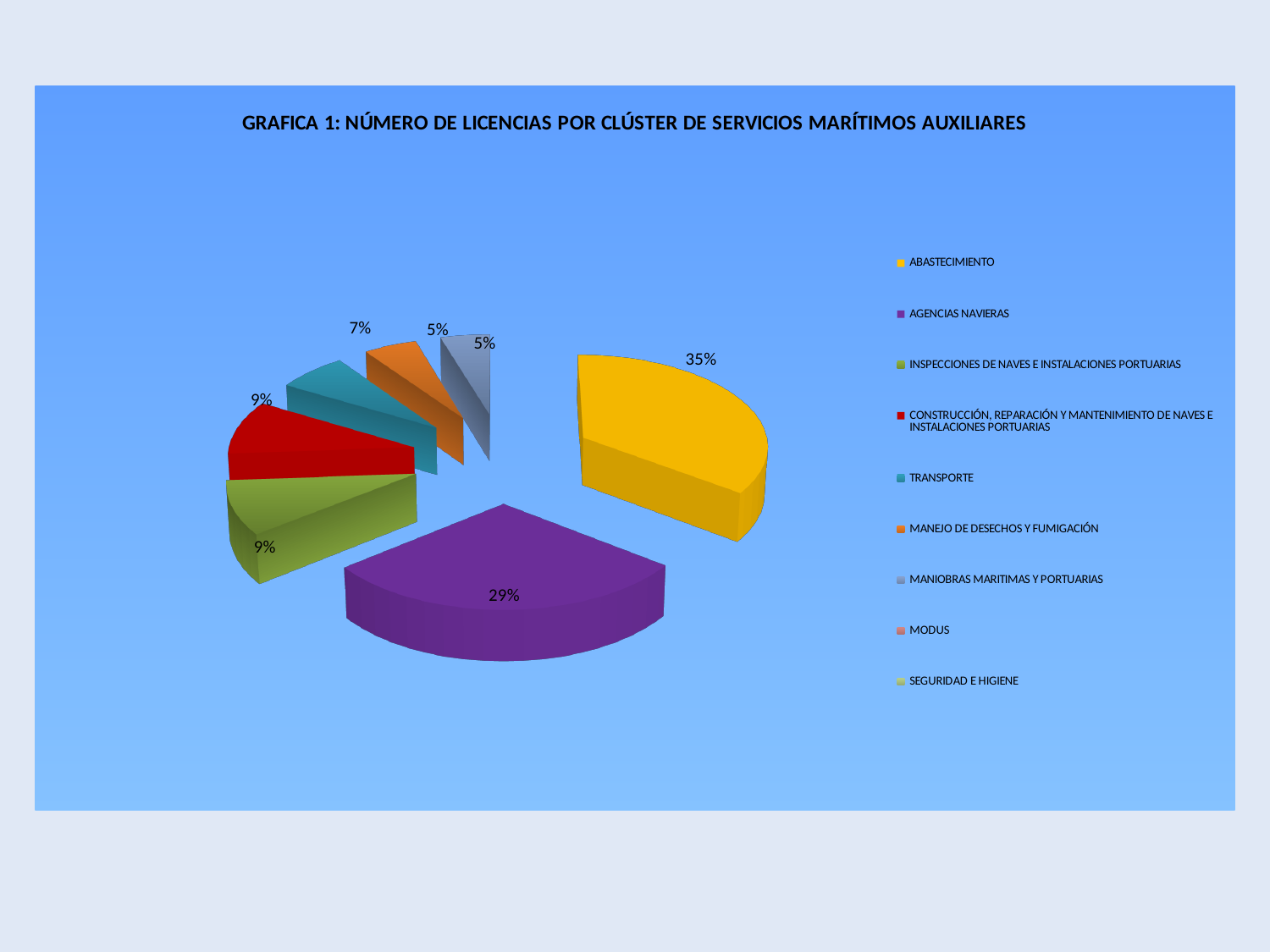
Which is larger, the share for ABASTECIMIENTO or the share for AGENCIAS NAVIERAS? ABASTECIMIENTO How many entries does the legend list? 9 What is the difference in percentage points between the ABASTECIMIENTO share (35%) and the AGENCIAS NAVIERAS share (29%)? 6 percentage points What percentage of licences does the ABASTECIMIENTO slice represent? 35% What type of chart is shown on the slide? Pie chart What percentage is shown for CONSTRUCCIÓN, REPARACIÓN Y MANTENIMIENTO DE NAVES E INSTALACIONES PORTUARIAS? 9% What colour is the ABASTECIMIENTO slice? Yellow What percentage is shown for MANEJO DE DESECHOS Y FUMIGACIÓN? 5% Which cluster has the largest share of licences? ABASTECIMIENTO What is the title of the chart? GRAFICA 1: NÚMERO DE LICENCIAS POR CLÚSTER DE SERVICIOS MARÍTIMOS AUXILIARES What percentage is shown for AGENCIAS NAVIERAS? 29% What percentage is shown for TRANSPORTE? 7%